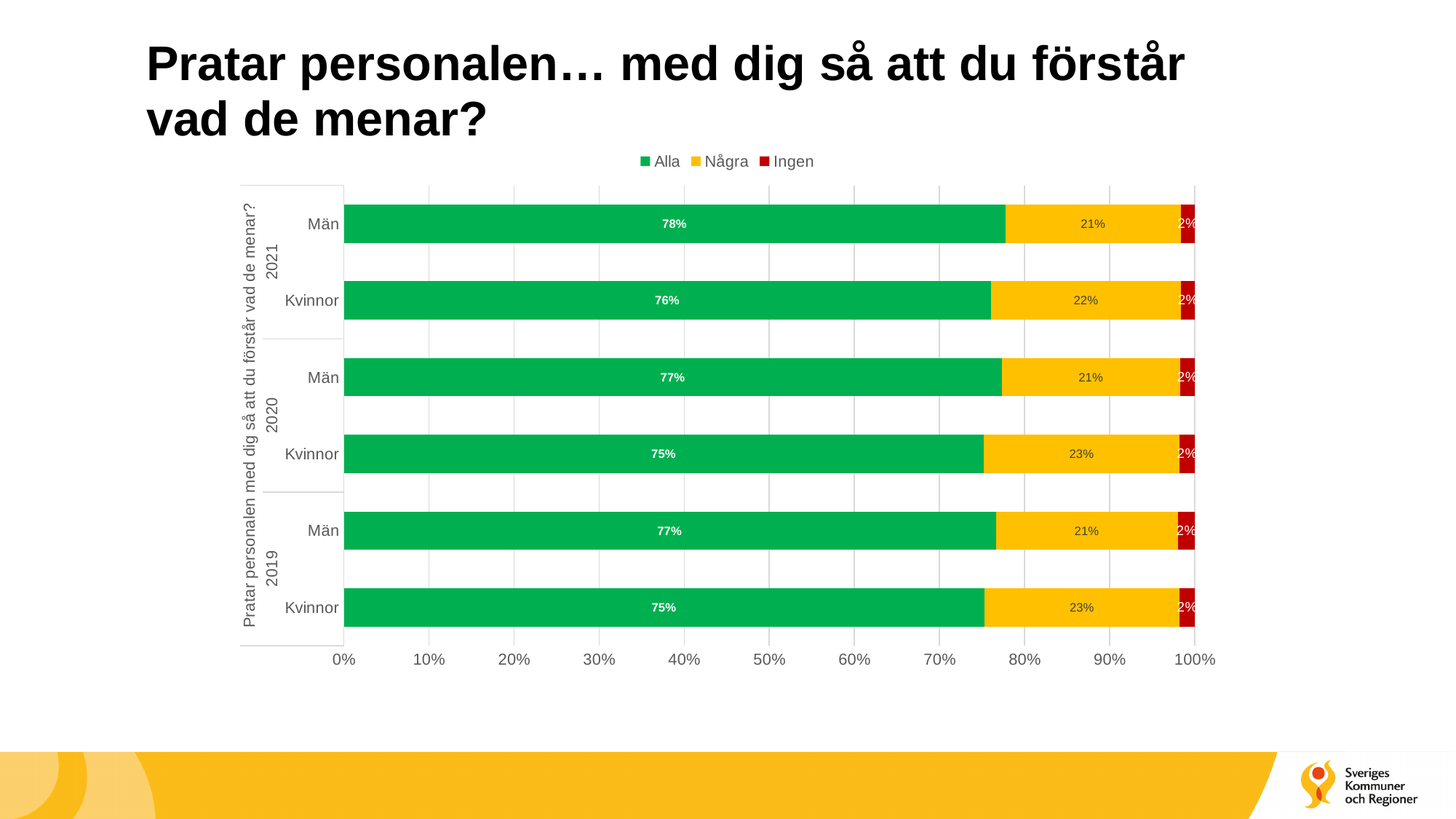
What kind of chart is shown on the slide? Stacked bar chart How many bars are plotted in the chart? 6 What is the value of "Alla" for Män in 2021? 78% Which series is shown in green? Alla What is the difference between the "Några" value for Kvinnor in 2020 and for Män in 2020? 2% What is the difference between the "Alla" value for Män in 2021 and for Kvinnor in 2021? 2% What is the value of "Alla" for Kvinnor in 2021? 76% Which is larger, the "Några" value for Kvinnor in 2019 or for Män in 2019? Kvinnor 2019 What is the value of "Några" for Kvinnor in 2020? 23% Which bar has the highest "Alla" value? Män 2021 How many series does the legend list? 3 What is the value of "Ingen" for Kvinnor in 2019? 2%